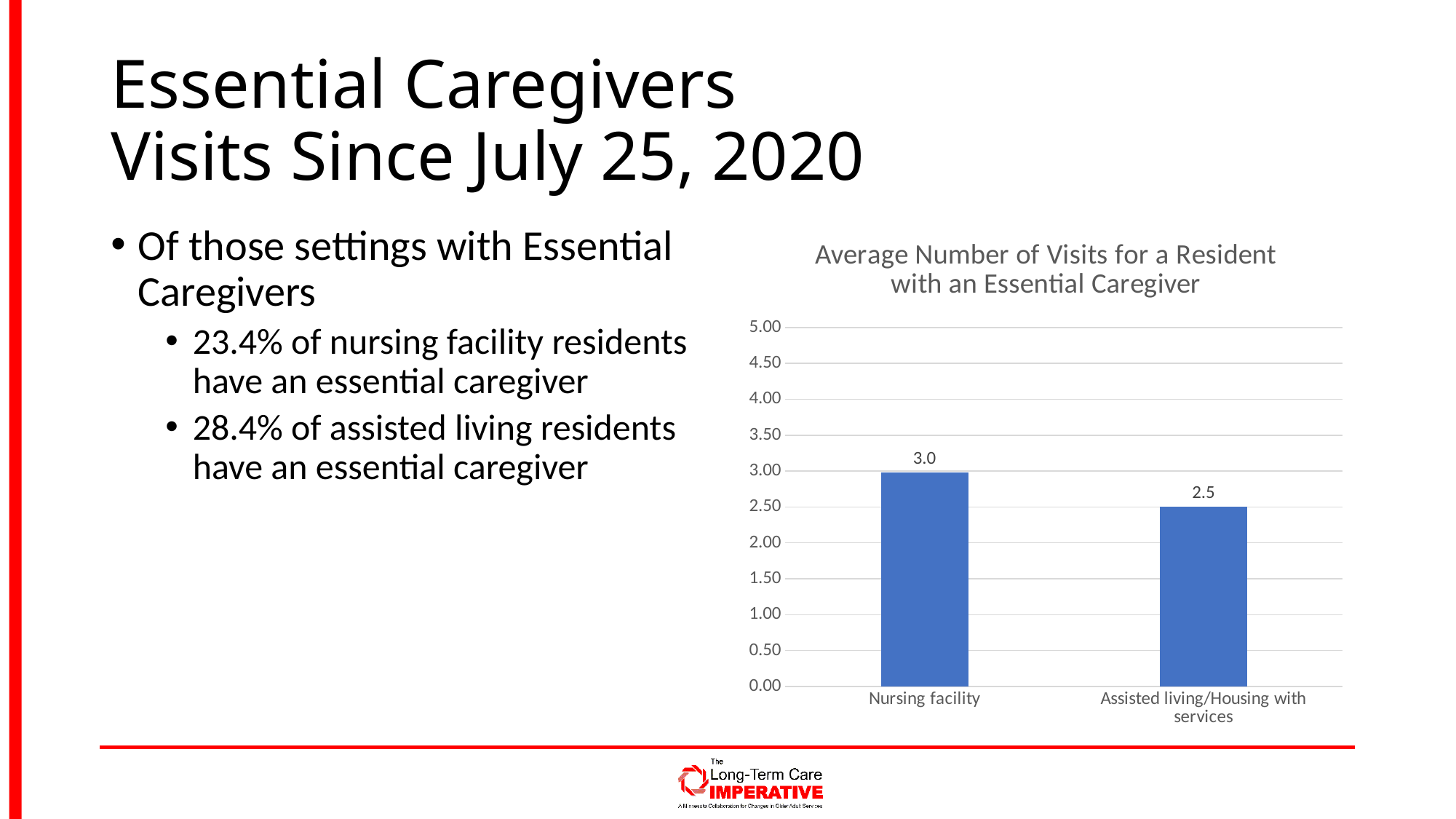
Which setting has the lower average number of visits? Assisted living/Housing with services How many categories are shown in the chart? 2 What is the difference between the average number of visits for nursing facility and assisted living/housing with services? 0.5 What is the title of the chart? Average Number of Visits for a Resident with an Essential Caregiver What is the average number of visits for a resident with an essential caregiver in a nursing facility? 3.0 What is the maximum value shown on the chart's vertical axis? 5.00 Which setting has the higher average number of visits? Nursing facility What kind of chart is shown on the slide? Bar chart Is the average number of visits higher for nursing facility or for assisted living/housing with services? Nursing facility What is the average number of visits for a resident with an essential caregiver in assisted living/housing with services? 2.5 Is the value for assisted living/housing with services greater or less than 3.00? less